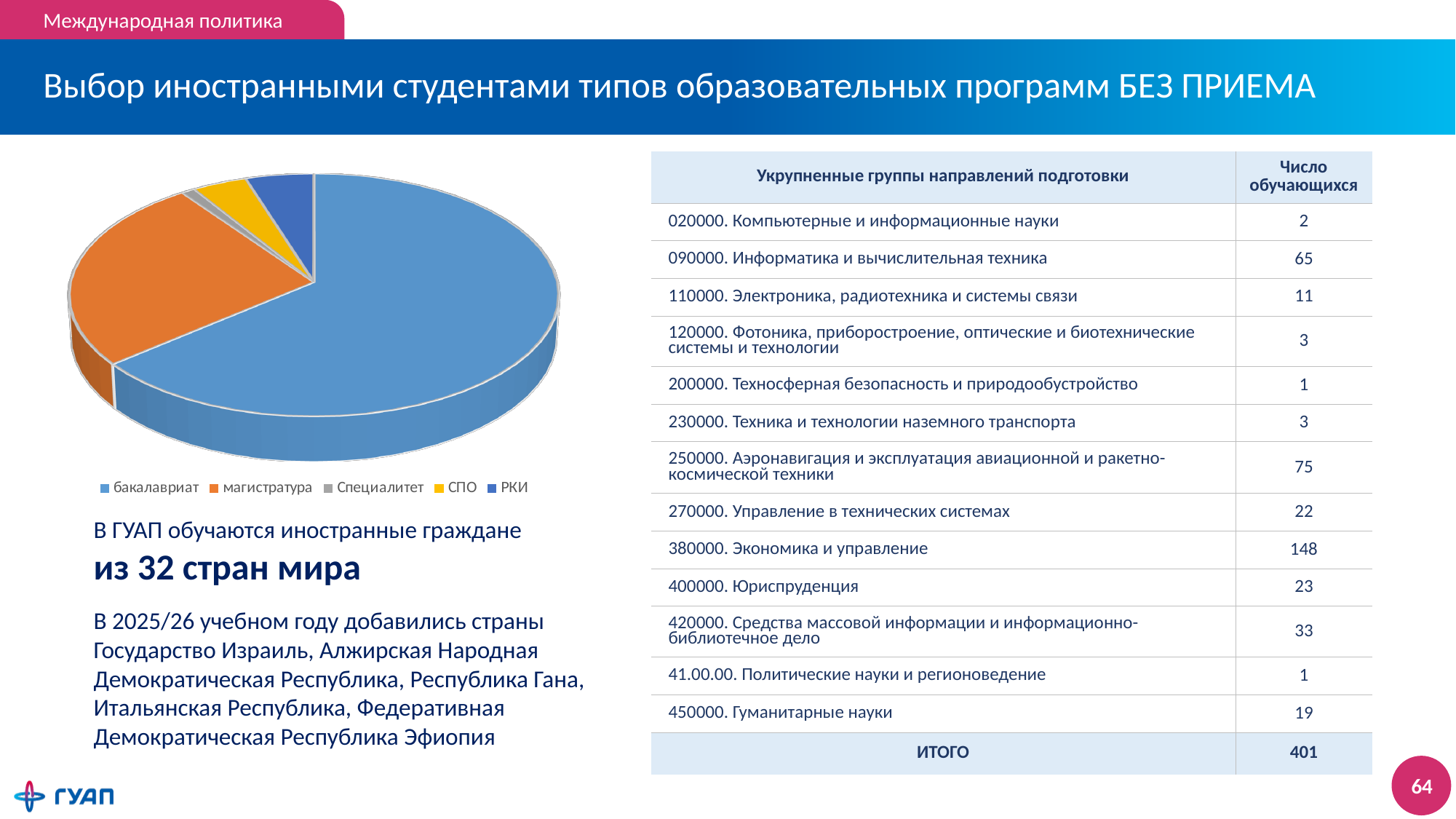
In the pie chart, which slice is larger: магистратура or СПО? магистратура In the pie chart, which slice is larger: бакалавриат or магистратура? бакалавриат How many entries does the legend of the pie chart list? 5 How many slices does the pie chart have? 5 In the pie chart, which slice is larger: магистратура or РКИ? магистратура What colour is the бакалавриат slice in the pie chart? Blue Which category has the smallest slice in the pie chart? Специалитет Which category has the largest slice in the pie chart? бакалавриат What kind of chart is shown on the left of the slide? Pie chart What colour is the магистратура slice in the pie chart? Orange